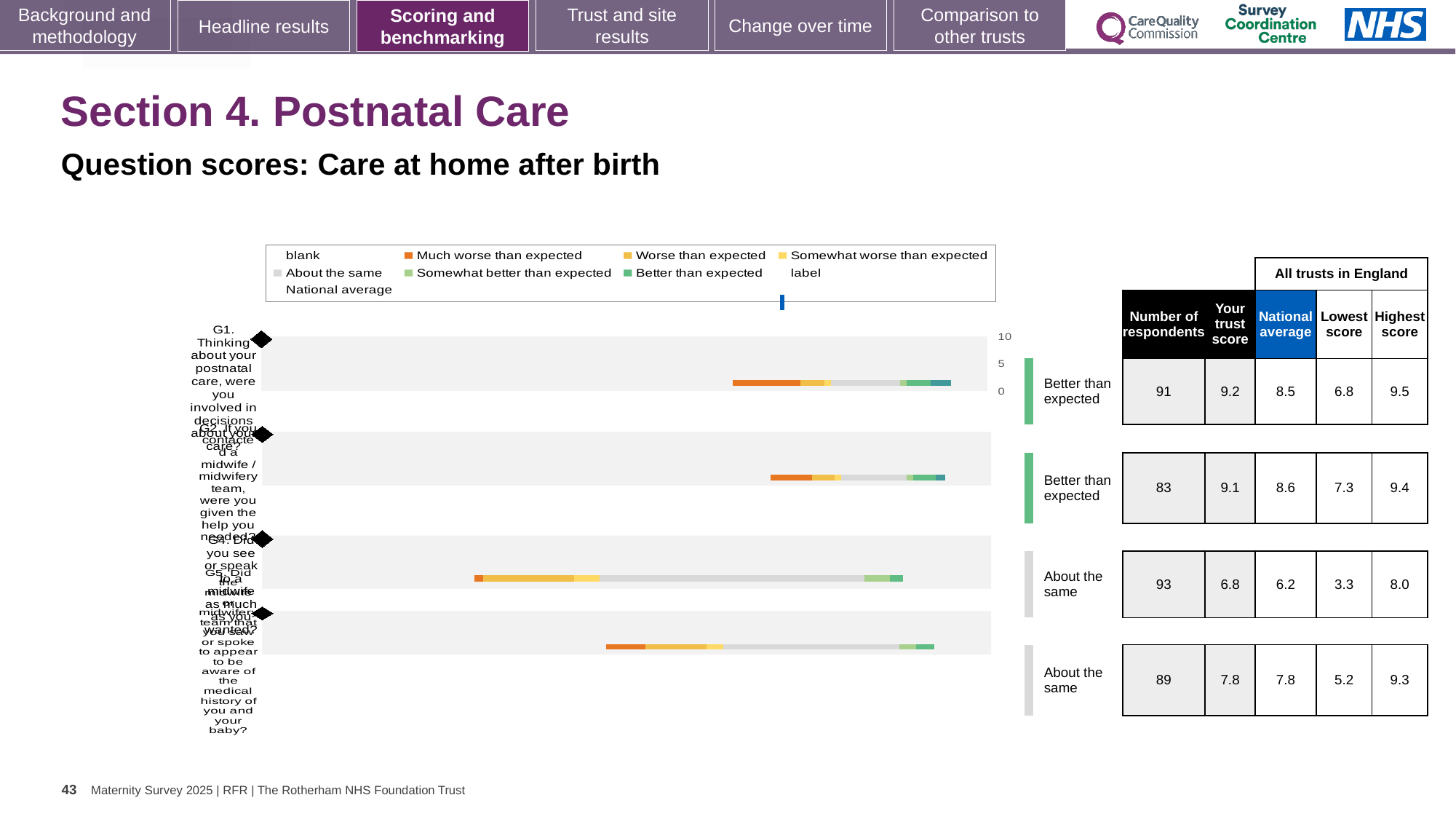
What kind of chart is shown on the slide? bar chart Which question row has the highest trust score in the table beside the chart? the first row (G1), 9.2 In the table beside the chart, what is the national average for the second question? 8.6 Which question row has the lowest trust score in the table beside the chart? the third row, 6.8 In the table beside the chart, what is the lowest score in England for the third question? 3.3 How many question bars are plotted in the chart? 4 In the table beside the chart, how many respondents answered the first question (G1)? 91 What benchmark category is shown next to the first question bar? Better than expected For the first question (G1), is the trust score or the national average larger? trust score (9.2) In the table beside the chart, what is the trust score for the first question (G1)? 9.2 In the table beside the chart, what is the highest score in England for the fourth question? 9.3 What is the difference between the trust score and the national average for the first question (G1)? 0.7